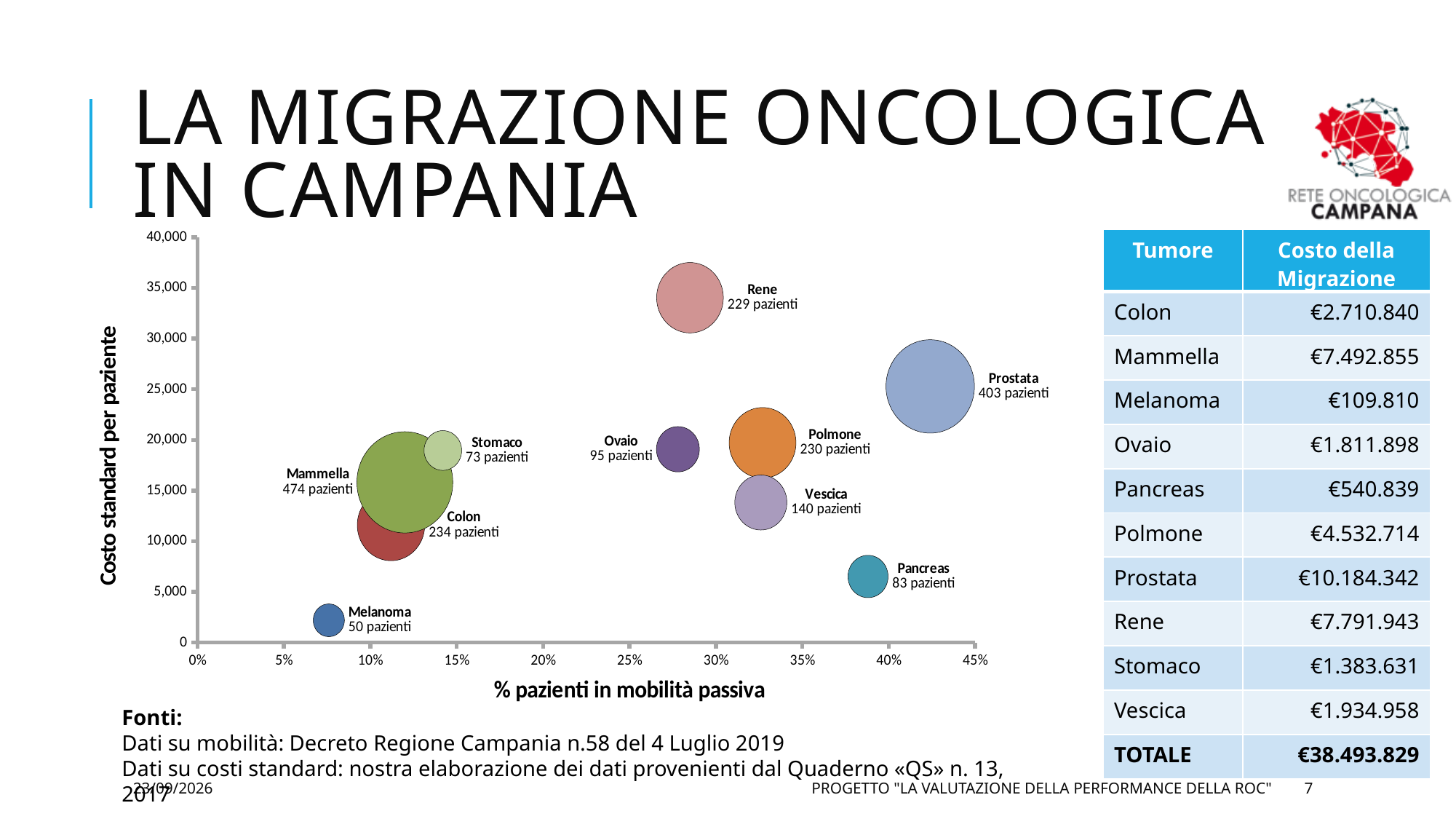
Which has a higher costo standard per paziente, Rene or Pancreas? Rene Is the costo standard per paziente for Rene greater or less than 30,000? greater Which tumour type has the smallest number of patients in the chart? Melanoma What is the label of the x axis of the chart? % pazienti in mobilità passiva What is the difference in patient numbers between Prostata and Colon in the chart? 169 How many patients are shown for Mammella in the chart? 474 pazienti How many patients are shown for Prostata in the chart? 403 pazienti Which tumour type has the largest number of patients in the chart? Mammella How many patients are shown for Pancreas in the chart? 83 pazienti What kind of chart is shown on the slide? bubble chart Is the costo standard per paziente for Melanoma greater or less than 5,000? less How many tumour types (bubbles) are plotted in the chart? 10